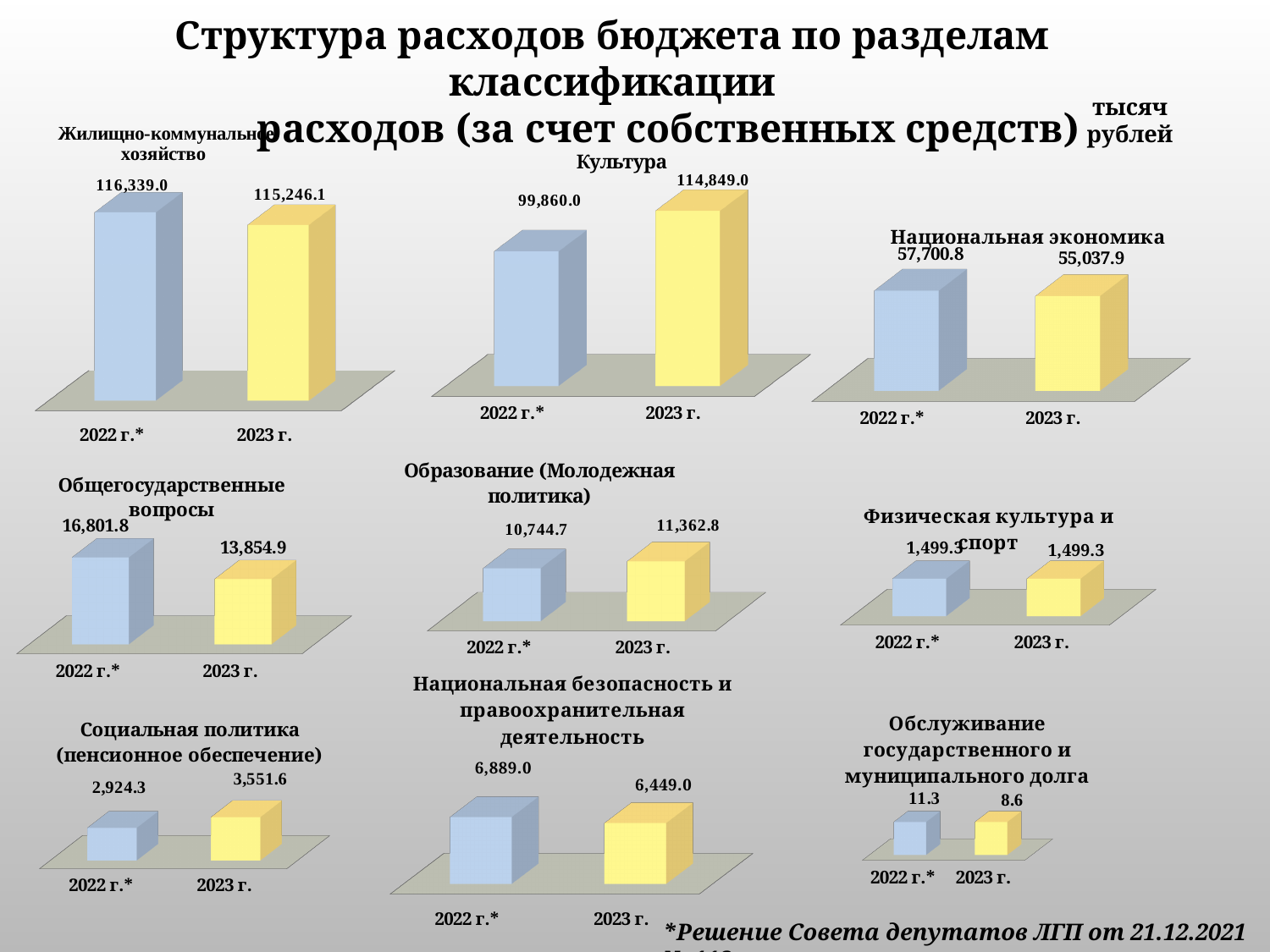
In the 'Социальная политика (пенсионное обеспечение)' chart, what is the difference between the 2023 г. and 2022 г.* values? 627.3 In the 'Национальная безопасность и правоохранительная деятельность' chart, is the value for 2022 г.* or 2023 г. larger? 2022 г.* In the 'Культура' chart, what is the value for 2023 г.? 114,849.0 In the 'Обслуживание государственного и муниципального долга' chart, what is the value for 2022 г.*? 11.3 In the 'Жилищно-коммунальное хозяйство' chart, what is the value for 2022 г.*? 116,339.0 In the 'Обслуживание государственного и муниципального долга' chart, do the values rise or fall from 2022 г.* to 2023 г.? Fall In the 'Национальная экономика' chart, what is the value for 2023 г.? 55,037.9 In the 'Культура' chart, what is the difference between the 2023 г. and 2022 г.* values? 14,989.0 In the 'Образование (Молодежная политика)' chart, how many bars are plotted? 2 In the 'Культура' chart, which year has the higher value? 2023 г. What type of chart is used for 'Физическая культура и спорт'? Bar chart In the 'Общегосударственные вопросы' chart, which year has the lower value? 2023 г.